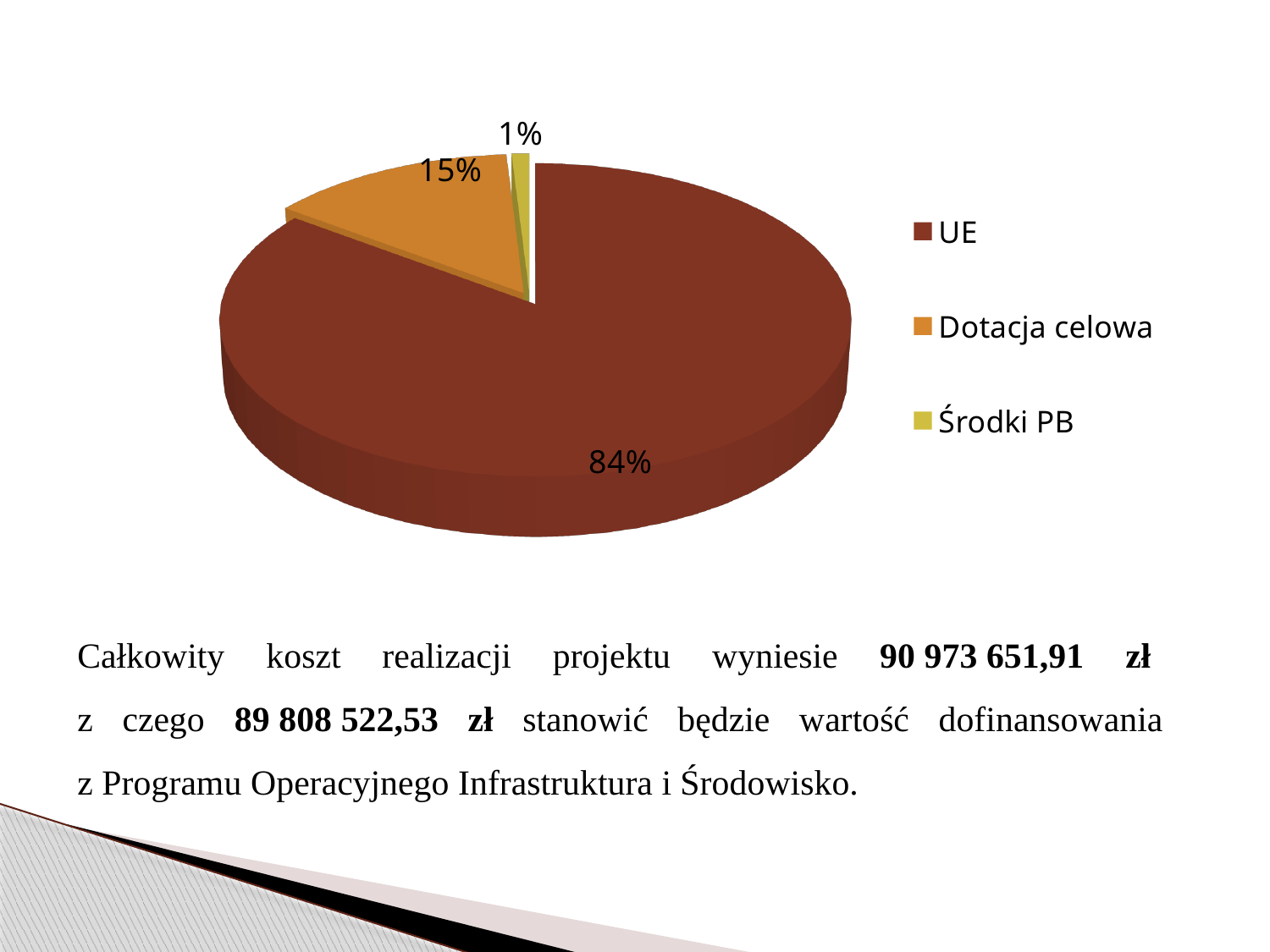
Which category has the largest slice of the pie? UE What share of the pie does UE represent? 84% How many categories does the pie chart show? 3 What share of the pie does Środki PB represent? 1% What kind of chart is shown on the slide? pie chart Which category has the smallest slice of the pie? Środki PB What is the difference in percentage points between the UE slice and the Dotacja celowa slice? 69 What share of the pie does Dotacja celowa represent? 15% Which legend entry is shown in yellow? Środki PB Which is larger, the Dotacja celowa slice or the Środki PB slice? Dotacja celowa What colour is the UE slice in the pie chart? dark red What is the difference in percentage points between the Dotacja celowa slice and the Środki PB slice? 14